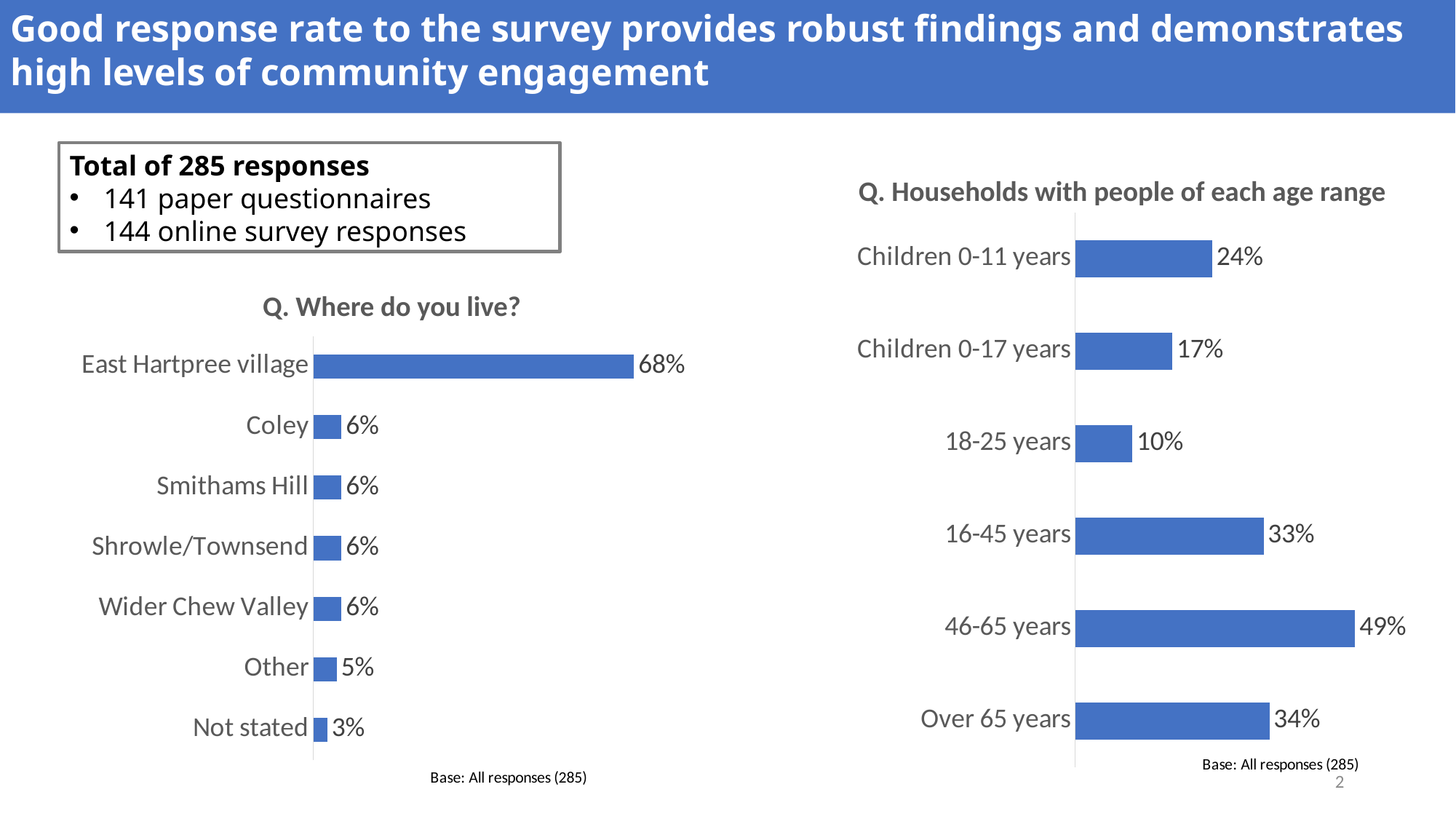
In the 'Q. Households with people of each age range' chart, what is the difference between Children 0-11 years and Children 0-17 years? 7% In the 'Q. Where do you live?' chart, which category has the lowest value? Not stated In the 'Q. Where do you live?' chart, what percentage of respondents live in East Hartpree village? 68% What kind of chart is 'Q. Households with people of each age range'? Bar chart In the 'Q. Households with people of each age range' chart, what is the value for 46-65 years? 49% In the 'Q. Households with people of each age range' chart, which age range has the highest value? 46-65 years In the 'Q. Where do you live?' chart, what is the value for Other? 5% In the 'Q. Where do you live?' chart, how many categories are shown? 7 In the 'Q. Where do you live?' chart, what is the difference between East Hartpree village and Coley? 62% What base is stated beneath the 'Q. Where do you live?' chart? All responses (285) In the 'Q. Households with people of each age range' chart, which age range has the lowest value? 18-25 years In the 'Q. Households with people of each age range' chart, which is larger: Over 65 years or 16-45 years? Over 65 years